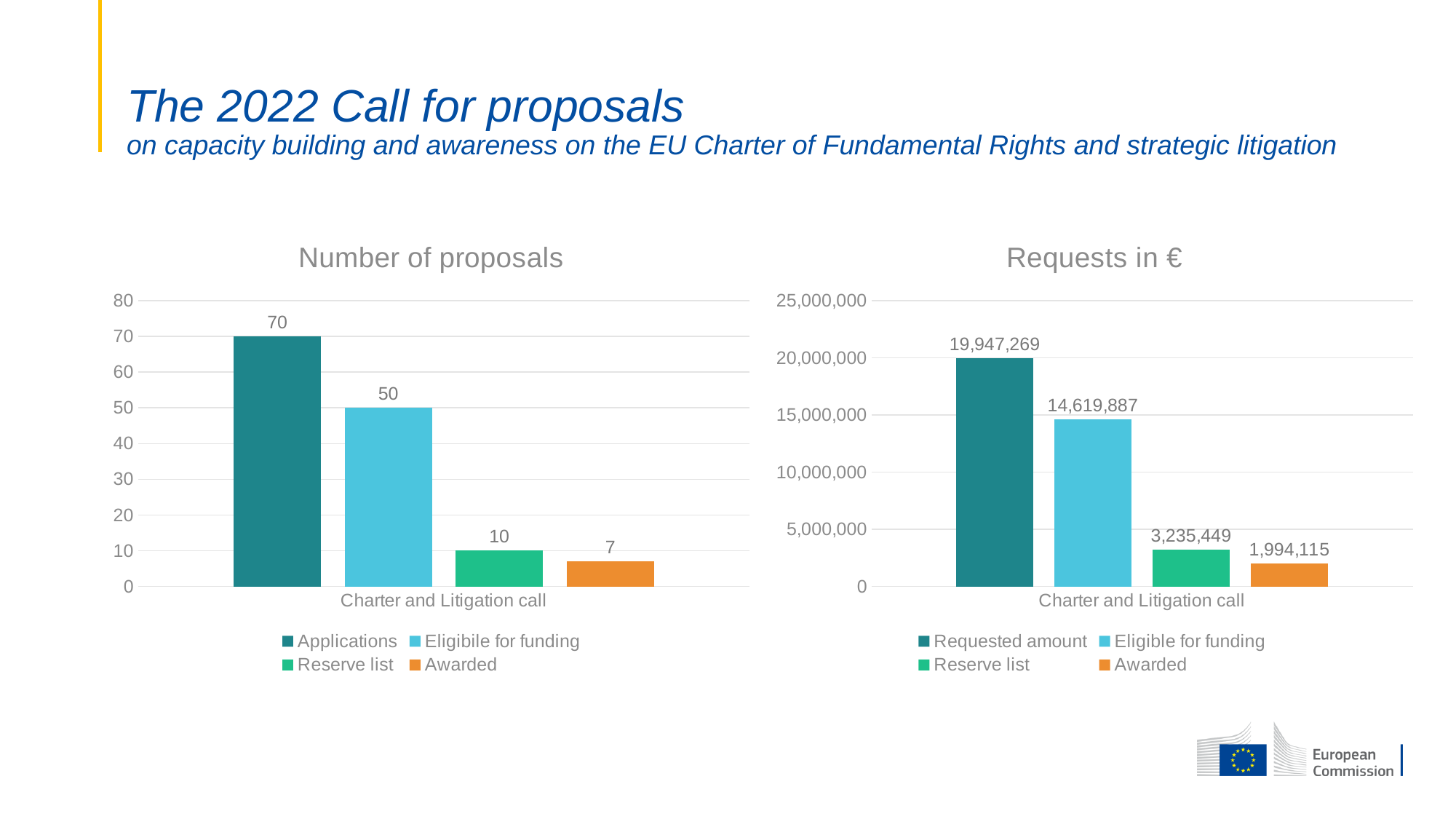
In the 'Requests in €' chart, which series has the highest value? Requested amount In the 'Number of proposals' chart, what is the difference between Applications and Eligibile for funding? 20 In the 'Number of proposals' chart, what is the value for Applications? 70 What kind of chart is the 'Number of proposals' chart? Bar chart In the 'Requests in €' chart, what is the value for Reserve list? 3,235,449 In the 'Number of proposals' chart, which series has the lowest value? Awarded In the 'Number of proposals' chart, which is larger: Reserve list or Awarded? Reserve list In the 'Requests in €' chart, what is the value for Awarded? 1,994,115 In the 'Number of proposals' chart, what is the value for Awarded? 7 In the 'Requests in €' chart, what is the difference between Requested amount and Eligible for funding? 5,327,382 How many series does the legend of the 'Requests in €' chart list? 4 In the 'Requests in €' chart, what is the Requested amount? 19,947,269